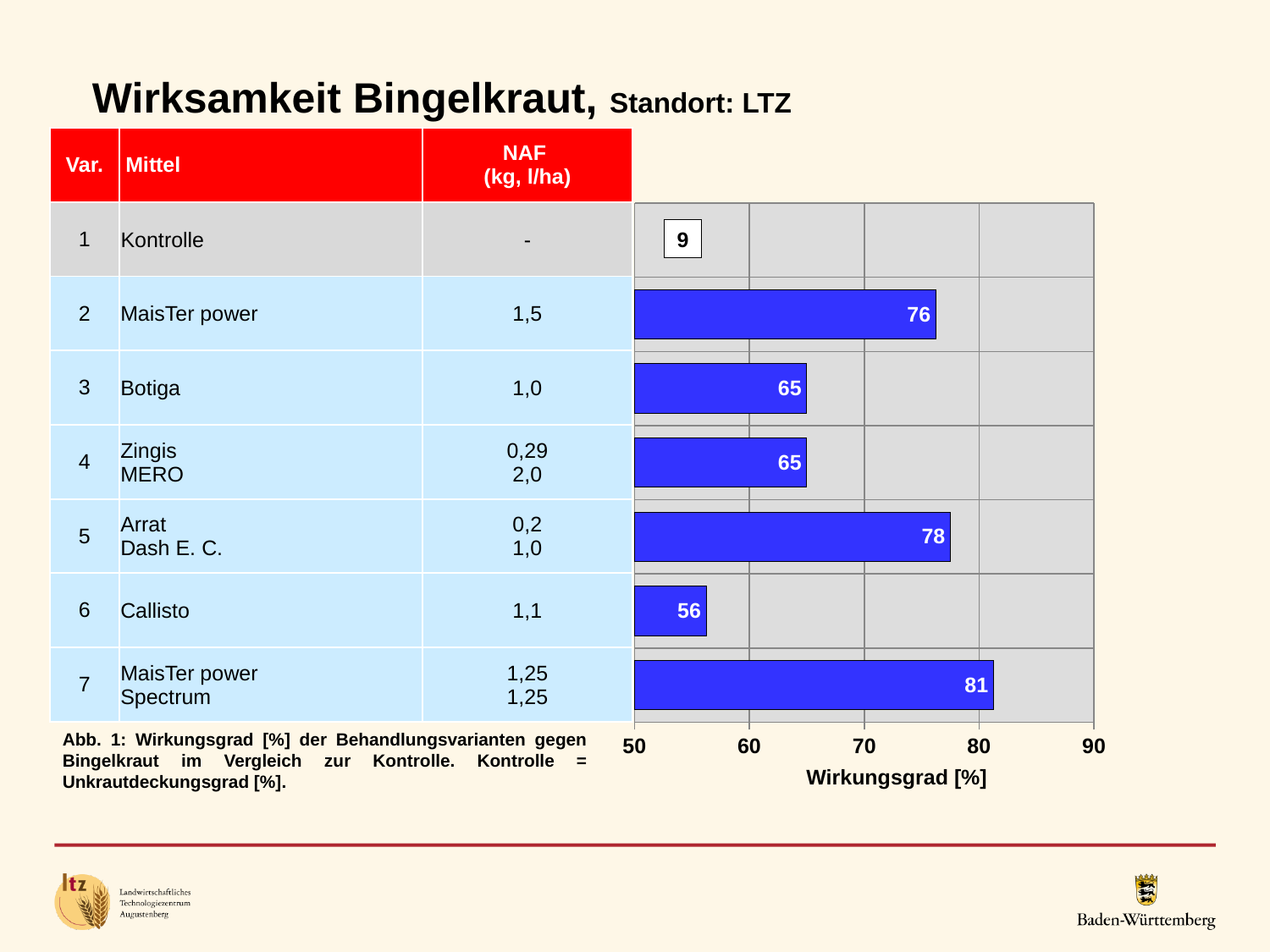
What is the difference in Wirkungsgrad [%] between MaisTer power + Spectrum (Var. 7) and Callisto (Var. 6)? 25 What is the difference in Wirkungsgrad [%] between Arrat + Dash E. C. (Var. 5) and MaisTer power (Var. 2)? 2 Among the treated variants (Var. 2 to 7), which has the lowest Wirkungsgrad [%]? Callisto (Var. 6) What is the label of the x axis of the chart? Wirkungsgrad [%] What is the Wirkungsgrad [%] value shown for Callisto (Var. 6)? 56 What is the Wirkungsgrad [%] value shown for Botiga (Var. 3)? 65 What value is shown for the Kontrolle row (Var. 1)? 9 Is the Wirkungsgrad [%] for Arrat + Dash E. C. (Var. 5) greater or less than 70? greater How many treatment variants (bars) are plotted in the chart, excluding the Kontrolle? 6 Which has a higher Wirkungsgrad [%]: MaisTer power (Var. 2) or Botiga (Var. 3)? MaisTer power (Var. 2) What type of chart is used to show the Wirkungsgrad [%] values? Bar chart Which treatment variant has the highest Wirkungsgrad [%]? MaisTer power + Spectrum (Var. 7)